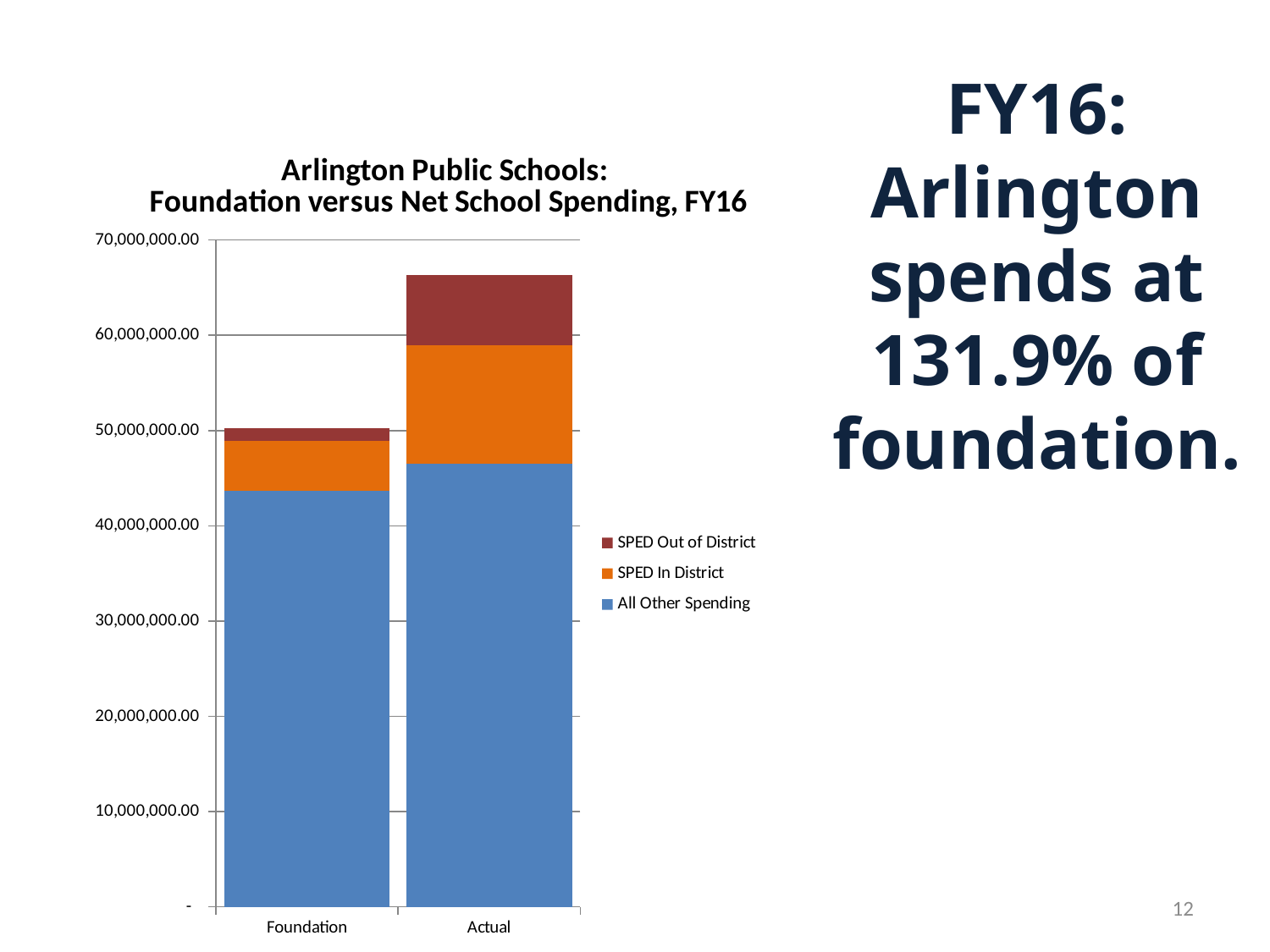
How many series does the chart's legend list? 3 Is the total of the Actual bar greater or less than 60,000,000.00? greater How many categories are shown on the x axis of the chart? 2 Which category has the taller stacked bar, Foundation or Actual? Actual Which category has the highest total spending in the chart? Actual Is the All Other Spending value for Foundation greater or less than 40,000,000.00? greater What kind of chart is shown on the slide? Stacked bar chart What is the title of the chart? Arlington Public Schools: Foundation versus Net School Spending, FY16 Which category has the larger SPED In District segment, Foundation or Actual? Actual Which category has the lowest total spending in the chart? Foundation Is the All Other Spending value for Actual greater or less than 50,000,000.00? less